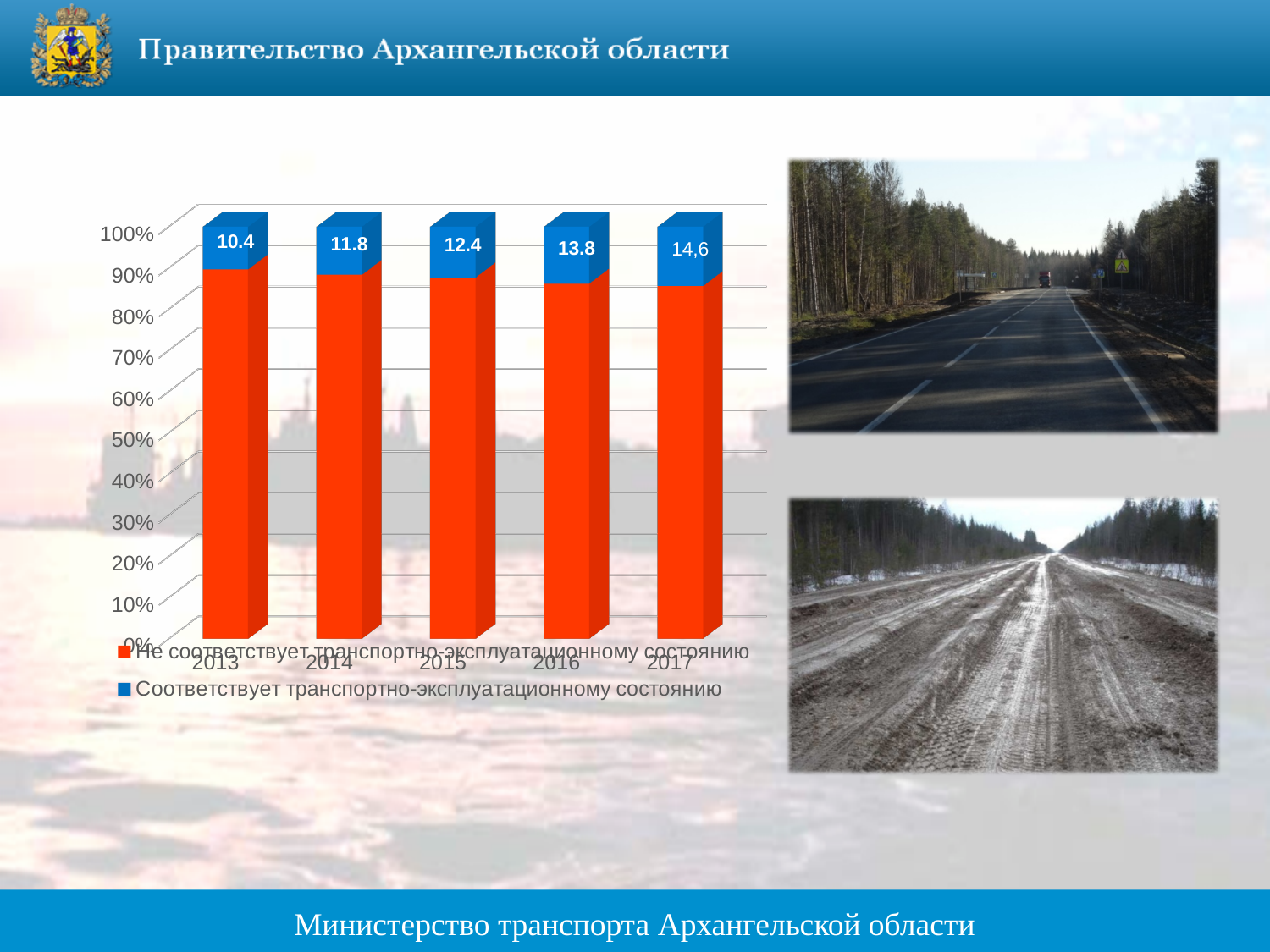
How many series does the chart legend list? 2 How many years are shown on the x axis of the chart? 5 Which year has the highest labelled value for the blue series (Соответствует транспортно-эксплуатационному состоянию)? 2017 Do the blue-series labels rise or fall from 2013 to 2017? Rise What is the value labelled on the blue segment for 2017? 14,6 Which year has the lowest labelled value for the blue series (Соответствует транспортно-эксплуатационному состоянию)? 2013 Is the red segment for 2013 greater or less than 80%? greater What is the value labelled on the blue segment for 2013? 10.4 Which year has the larger blue-series label, 2014 or 2016? 2016 What is the value labelled on the blue segment for 2015? 12.4 What kind of chart is shown on the slide? Stacked bar chart What is the difference between the blue-series labels for 2016 and 2013? 3.4